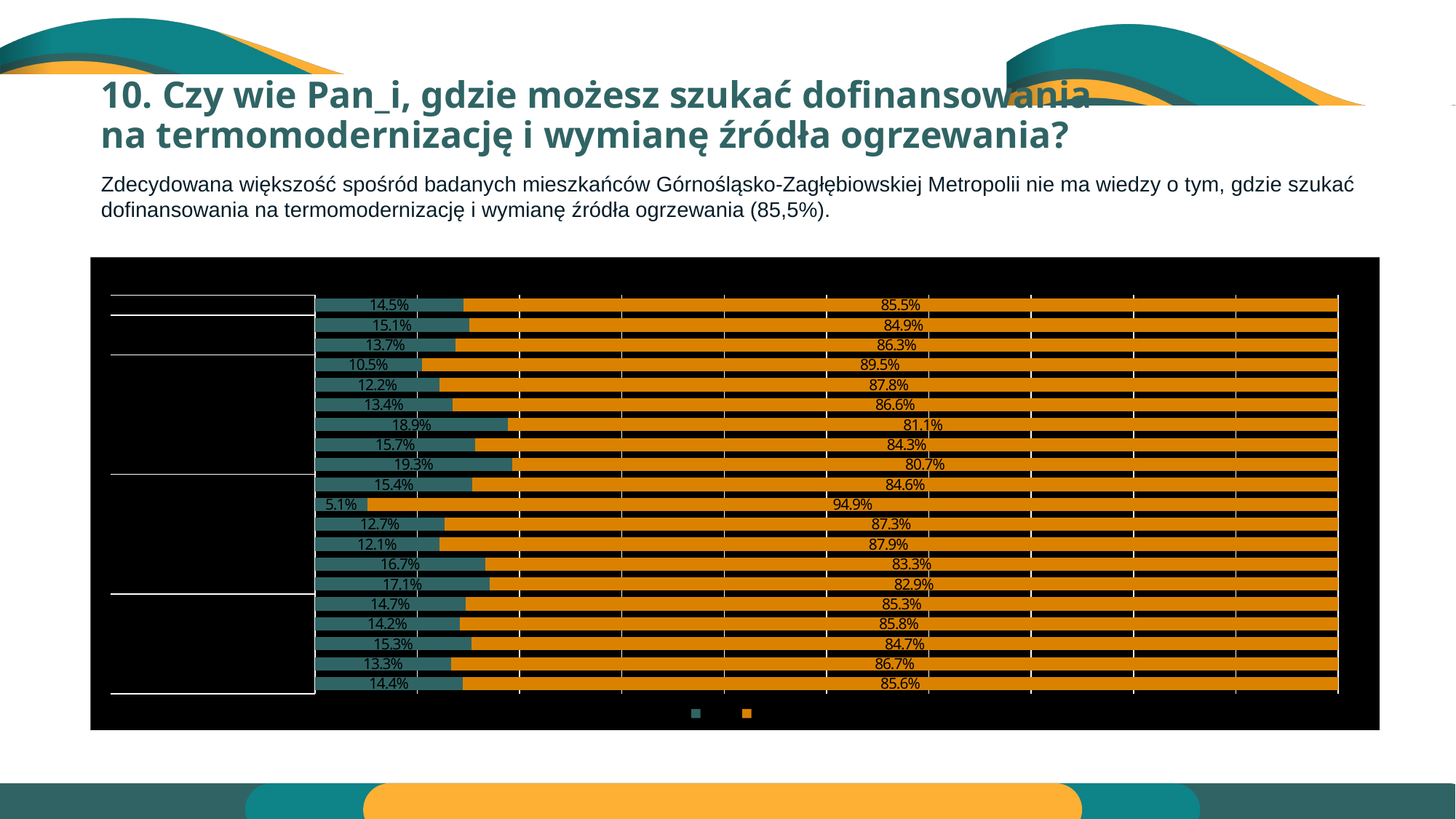
What is the total of the two segments in the topmost bar? 100% What is the orange value of the bottom bar in the chart? 85.6% What is the lowest orange value shown in the chart? 80.7% How many series does the legend show? 2 How many bars (rows) does the chart contain? 20 What is the highest orange value shown in the chart? 94.9% What is the orange (right-hand) value of the topmost bar in the chart? 85.5% What is the highest teal value shown in the chart? 19.3% What kind of chart is shown on the slide? stacked bar chart What is the teal (left-hand) value of the topmost bar in the chart? 14.5% Which colour is used for the larger segment in every bar of the chart? orange What is the lowest teal value shown in the chart? 5.1%